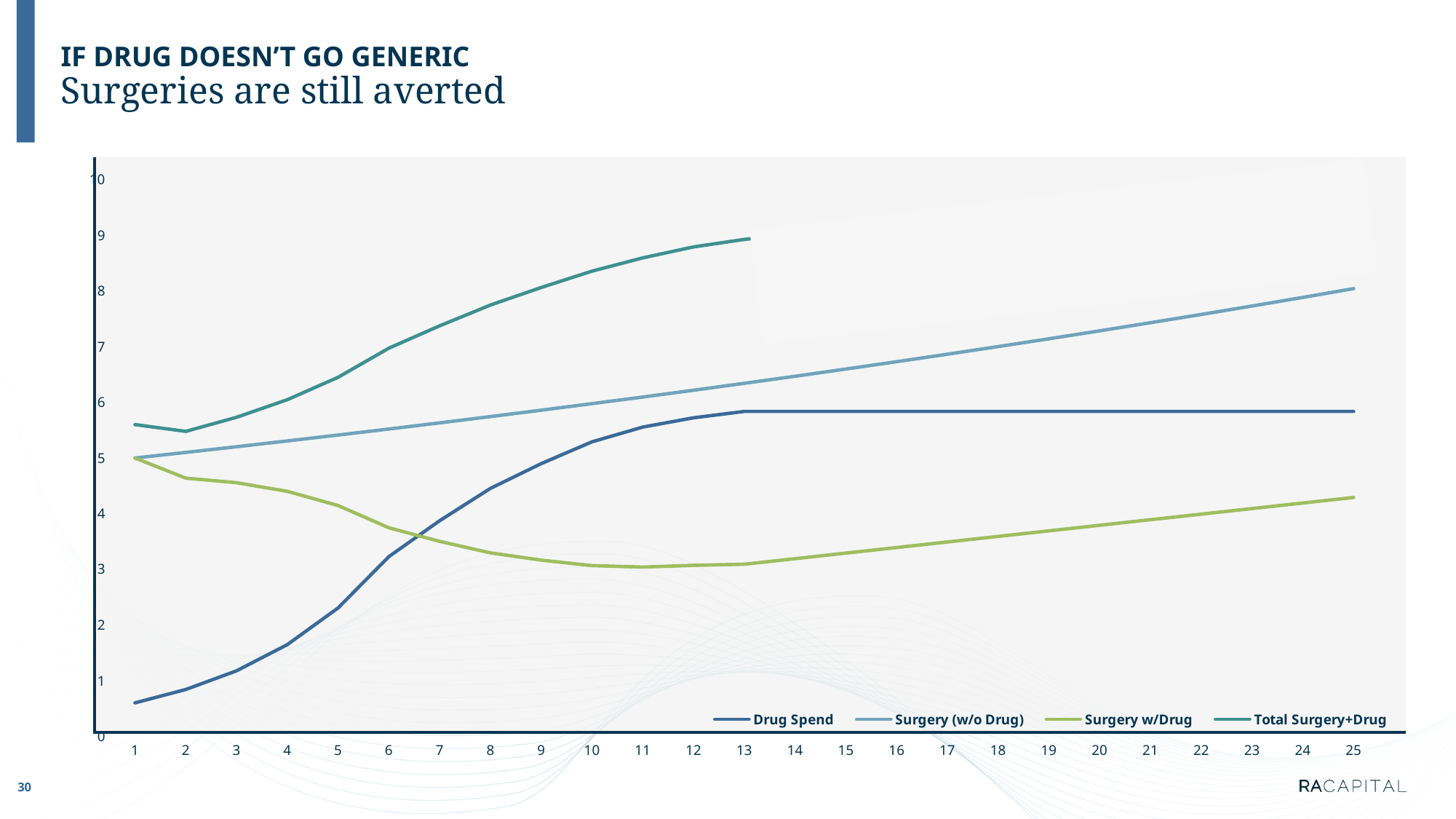
At x = 25, which is larger: Surgery (w/o Drug) or Surgery w/Drug? Surgery (w/o Drug) Is the value for Total Surgery+Drug at x = 13 greater or less than 8? greater How many points are labelled along the x axis? 25 Is the value for Drug Spend at x = 25 greater or less than 6? less What kind of chart is shown on the slide? Line chart Which series has the lowest value at x = 1? Drug Spend Which series has the highest value at x = 13? Total Surgery+Drug What is the value of Surgery w/Drug at x = 1? 5 Does the Surgery (w/o Drug) line rise or fall from x = 1 to x = 25? Rise Is the value for Drug Spend at x = 1 greater or less than 1? less How many series does the legend list? 4 What is the value of Surgery (w/o Drug) at x = 1? 5